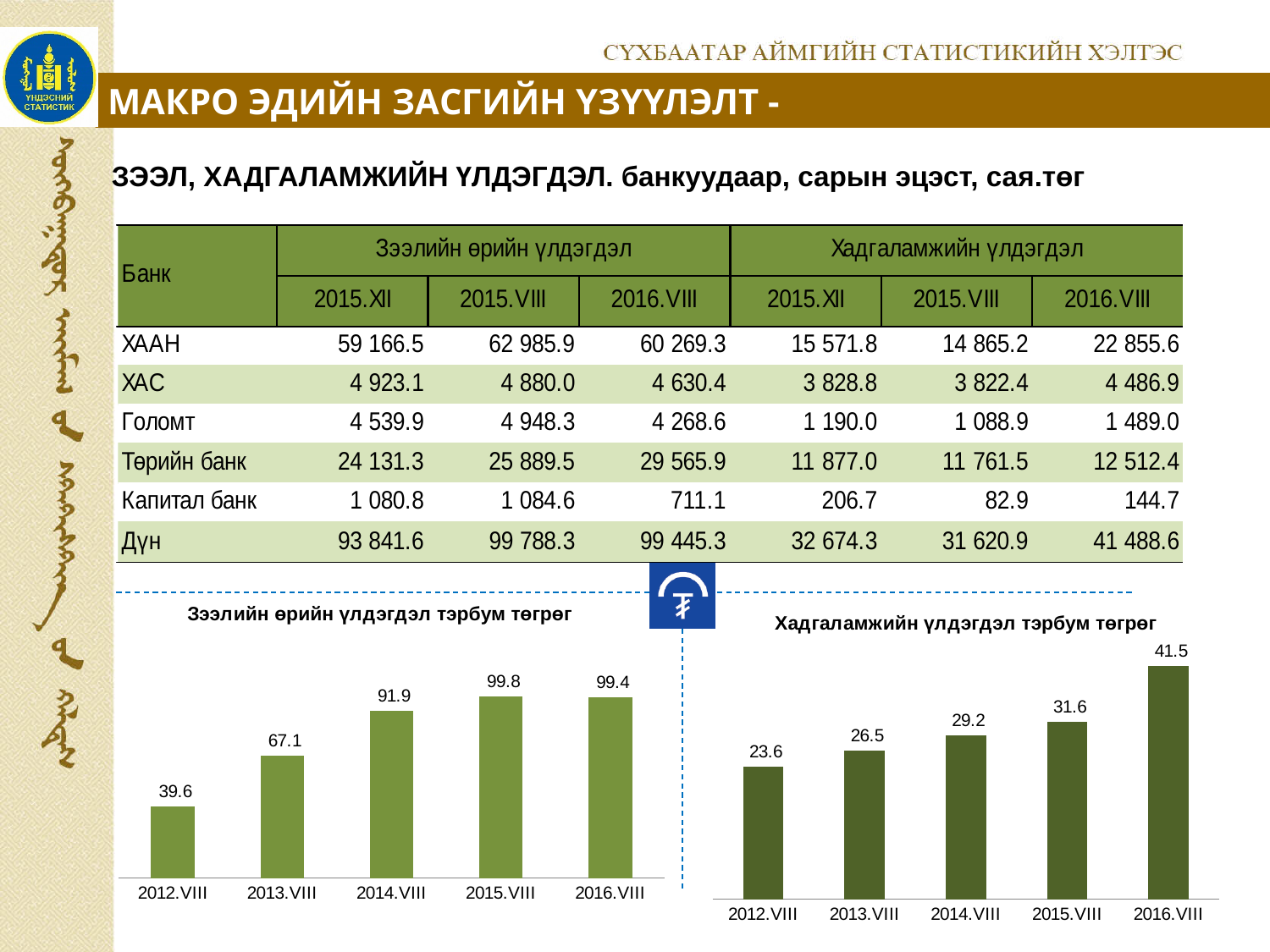
In the chart titled "Хадгаламжийн үлдэгдэл тэрбум төгрөг", which period has the lowest value? 2012.VIII In the chart titled "Зээлийн өрийн үлдэгдэл тэрбум төгрөг", what is the value for 2014.VIII? 91.9 What kind of chart is the one titled "Зээлийн өрийн үлдэгдэл тэрбум төгрөг"? Bar chart In the chart titled "Хадгаламжийн үлдэгдэл тэрбум төгрөг", how many bars are plotted? 5 In the chart titled "Хадгаламжийн үлдэгдэл тэрбум төгрөг", what is the value for 2013.VIII? 26.5 In the chart titled "Зээлийн өрийн үлдэгдэл тэрбум төгрөг", what is the difference between the values for 2013.VIII and 2012.VIII? 27.5 What is the title of the bar chart on the right side of the slide? Хадгаламжийн үлдэгдэл тэрбум төгрөг In the chart titled "Зээлийн өрийн үлдэгдэл тэрбум төгрөг", which is larger, the value for 2014.VIII or the value for 2013.VIII? 2014.VIII In the chart titled "Хадгаламжийн үлдэгдэл тэрбум төгрөг", do the values rise or fall from 2012.VIII to 2016.VIII? Rise In the chart titled "Зээлийн өрийн үлдэгдэл тэрбум төгрөг", what is the value for 2016.VIII? 99.4 In the chart titled "Зээлийн өрийн үлдэгдэл тэрбум төгрөг", which period has the highest value? 2015.VIII In the chart titled "Хадгаламжийн үлдэгдэл тэрбум төгрөг", what is the difference between the values for 2016.VIII and 2015.VIII? 9.9